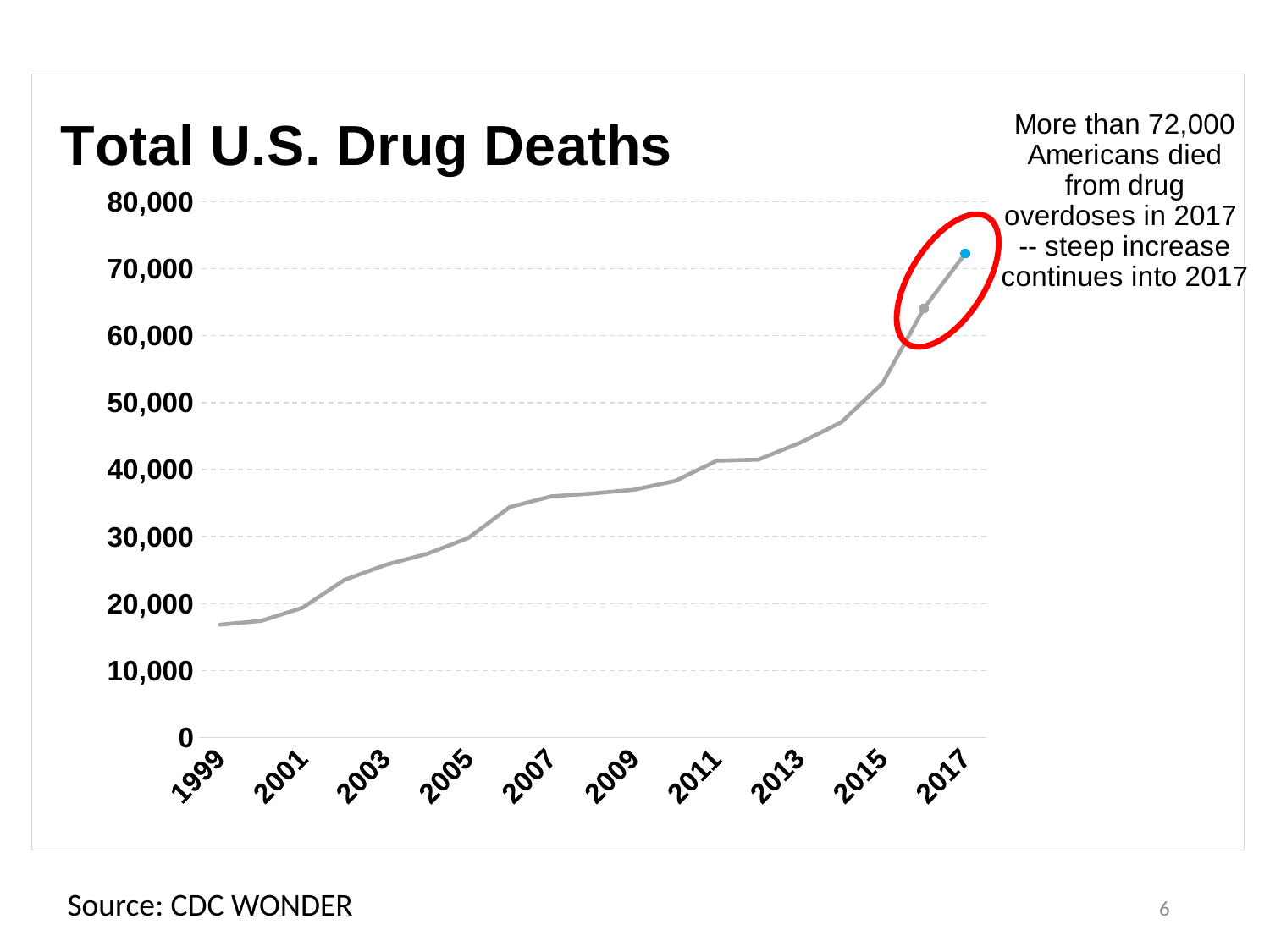
Is the value for 2003 greater or less than 30,000? less Which year has the highest number of drug deaths? 2017 Do drug deaths rise or fall from 1999 to 2017? rise What is the title of the chart? Total U.S. Drug Deaths Which year has more drug deaths, 2009 or 2013? 2013 What kind of chart is shown on the slide? line chart Is the value for 1999 greater or less than 20,000? less Is the value for 2007 greater or less than 40,000? less What is the source cited for the chart? CDC WONDER Which year has the lowest number of drug deaths? 1999